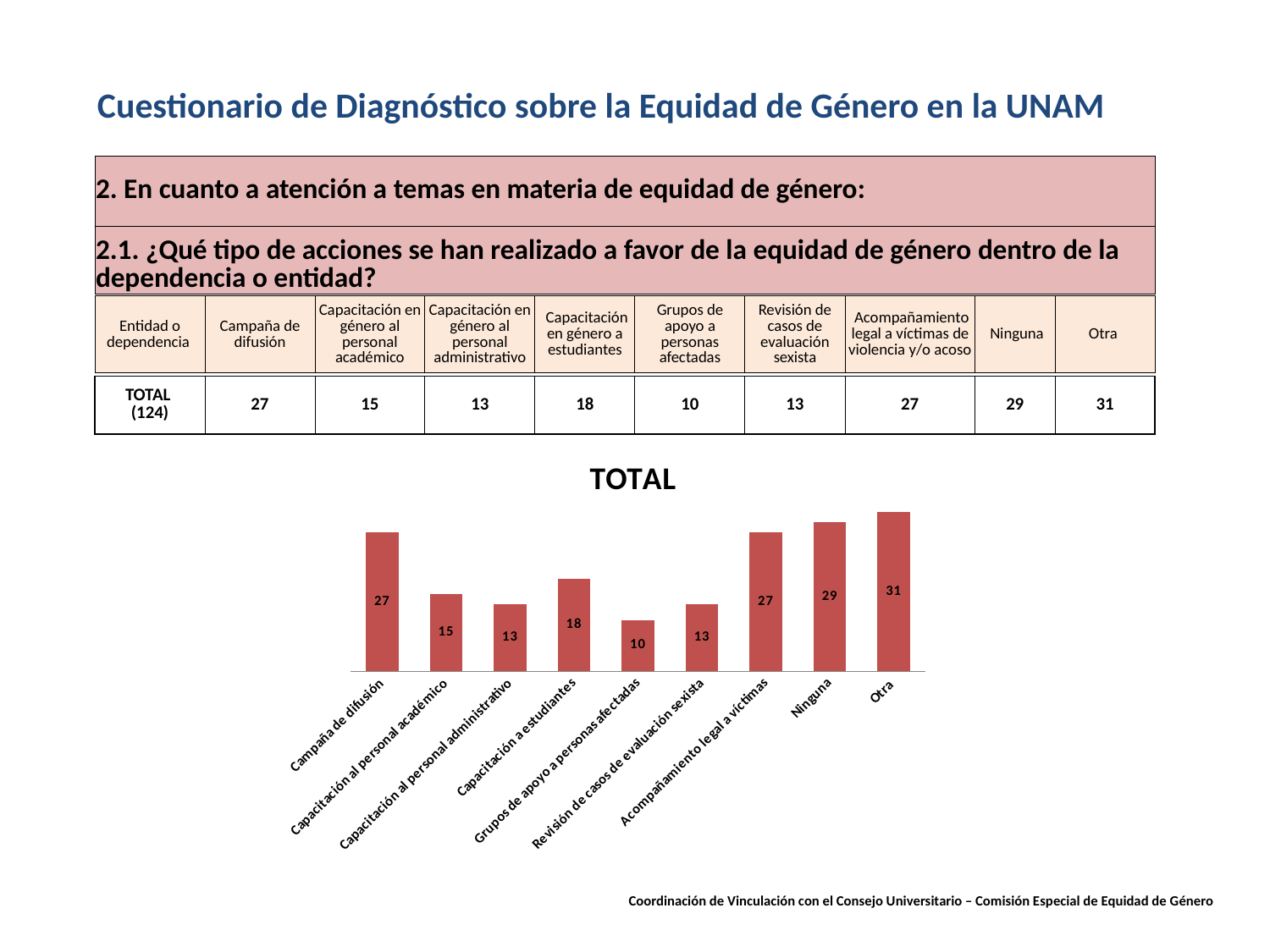
What is the value for "Capacitación a estudiantes" in the TOTAL chart? 18 Which category has the lowest value in the TOTAL chart? Grupos de apoyo a personas afectadas What is the difference between the values for "Campaña de difusión" and "Capacitación al personal académico" in the TOTAL chart? 12 What is the value for "Grupos de apoyo a personas afectadas" in the TOTAL chart? 10 What is the title of the chart on the slide? TOTAL How many categories are shown in the TOTAL chart? 9 What is the value for "Ninguna" in the TOTAL chart? 29 What is the difference between the values for "Otra" and "Grupos de apoyo a personas afectadas" in the TOTAL chart? 21 Which category has the highest value in the TOTAL chart? Otra What is the value for "Otra" in the TOTAL chart? 31 Which is larger in the TOTAL chart: the value for "Ninguna" or the value for "Capacitación a estudiantes"? Ninguna What type of chart is the TOTAL chart? Bar chart